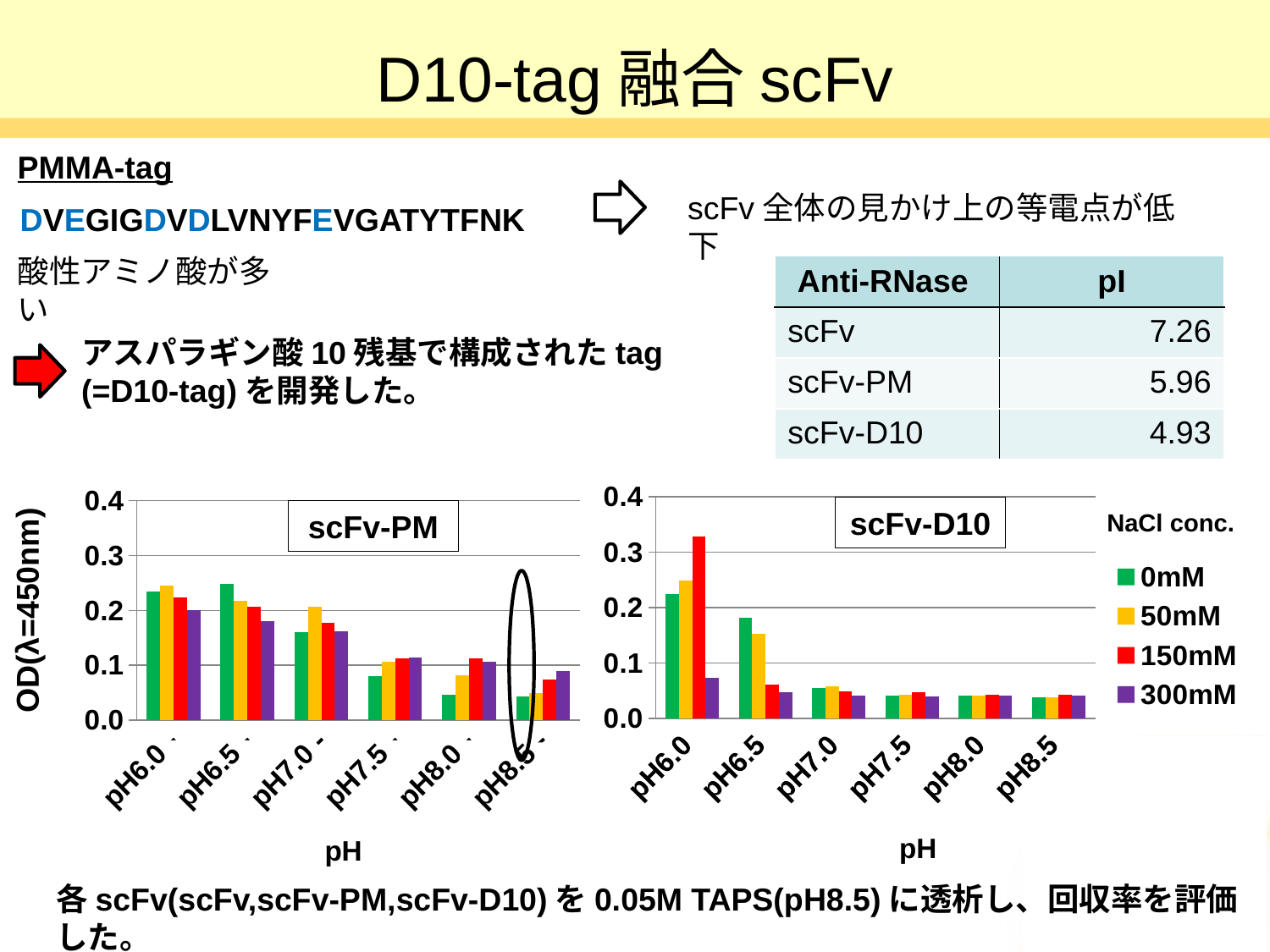
How many NaCl concentration series does the legend list? 4 In the scFv-PM chart, is the value for 0mM at pH6.5 greater or less than 0.2? greater In the scFv-D10 chart, which is larger at pH6.0: the 150mM value or the 0mM value? 150mM In the scFv-D10 chart, is the value for 300mM at pH6.0 greater or less than 0.1? less What is the label of the y axis on the scFv-PM chart? OD(λ=450nm) In the scFv-PM chart, is the value for 0mM at pH8.5 greater or less than 0.1? less In the scFv-D10 chart, do the values generally rise or fall as pH increases from pH6.0 to pH8.5? fall In the scFv-D10 chart, which NaCl concentration gives the lowest value at pH6.0? 300mM What kind of chart is the scFv-PM chart on the left? bar chart How many pH categories are shown on the x axis of the scFv-D10 chart? 6 In the scFv-D10 chart, which NaCl concentration gives the highest value at pH6.0? 150mM